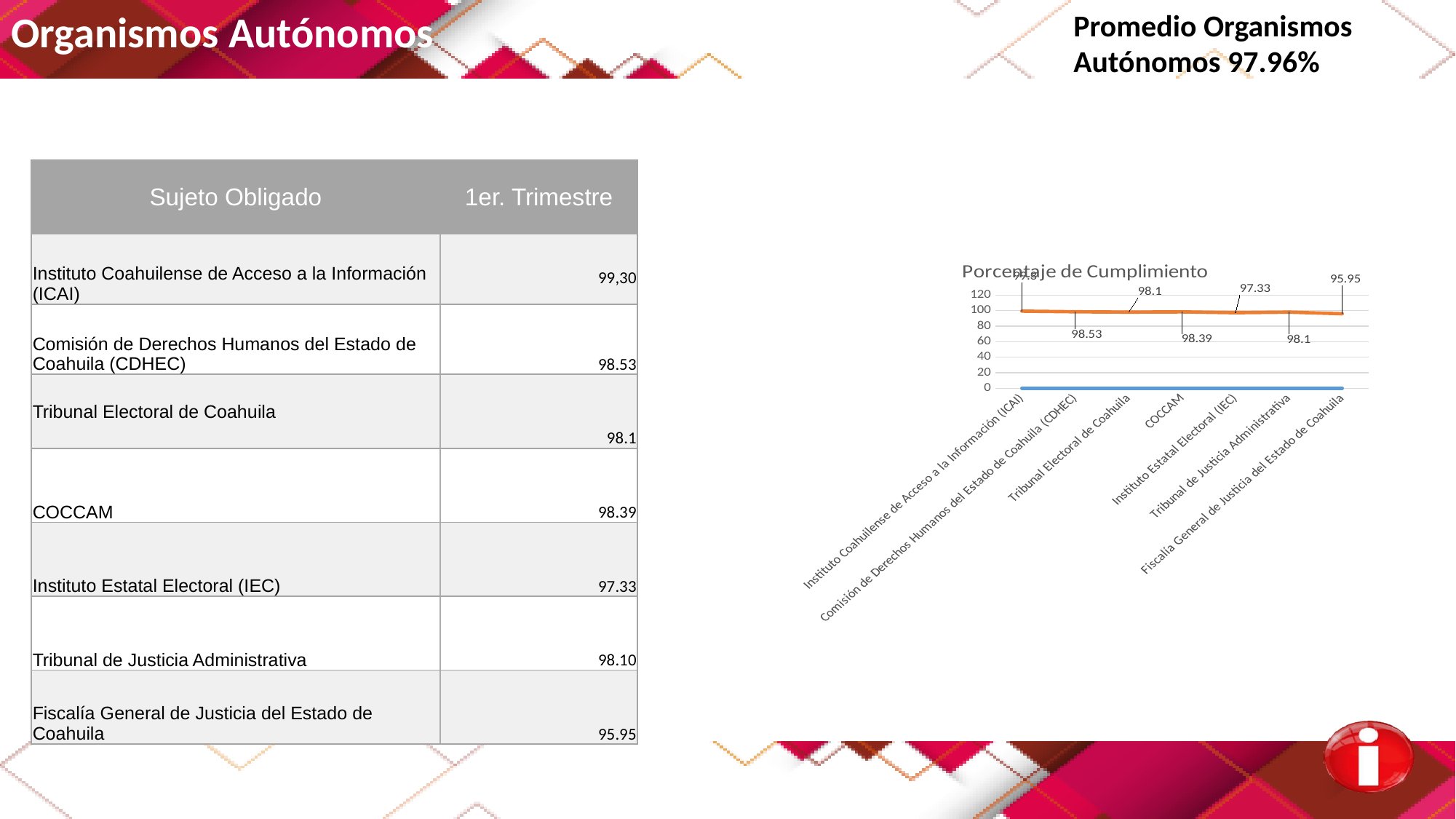
In the "Porcentaje de Cumplimiento" chart, what is the value for COCCAM? 98.39 In the "Porcentaje de Cumplimiento" chart, what is the difference between the values for COCCAM and Instituto Estatal Electoral (IEC)? 1.06 What type of chart is shown under the title "Porcentaje de Cumplimiento"? line chart In the "Porcentaje de Cumplimiento" chart, what is the value for Tribunal Electoral de Coahuila? 98.1 In the "Porcentaje de Cumplimiento" chart, what is the value for Fiscalía General de Justicia del Estado de Coahuila? 95.95 In the "Porcentaje de Cumplimiento" chart, is the value for Instituto Estatal Electoral (IEC) greater or less than 80? greater In the "Porcentaje de Cumplimiento" chart, which is larger: the value for Comisión de Derechos Humanos del Estado de Coahuila (CDHEC) or the value for Fiscalía General de Justicia del Estado de Coahuila? Comisión de Derechos Humanos del Estado de Coahuila (CDHEC) In the "Porcentaje de Cumplimiento" chart, what is the value for Instituto Estatal Electoral (IEC)? 97.33 How many categories are shown on the x axis of the "Porcentaje de Cumplimiento" chart? 7 In the "Porcentaje de Cumplimiento" chart, what is the value for Comisión de Derechos Humanos del Estado de Coahuila (CDHEC)? 98.53 In the "Porcentaje de Cumplimiento" chart, which category has the lowest labelled value? Fiscalía General de Justicia del Estado de Coahuila What is the title of the chart on the right side of the slide? Porcentaje de Cumplimiento